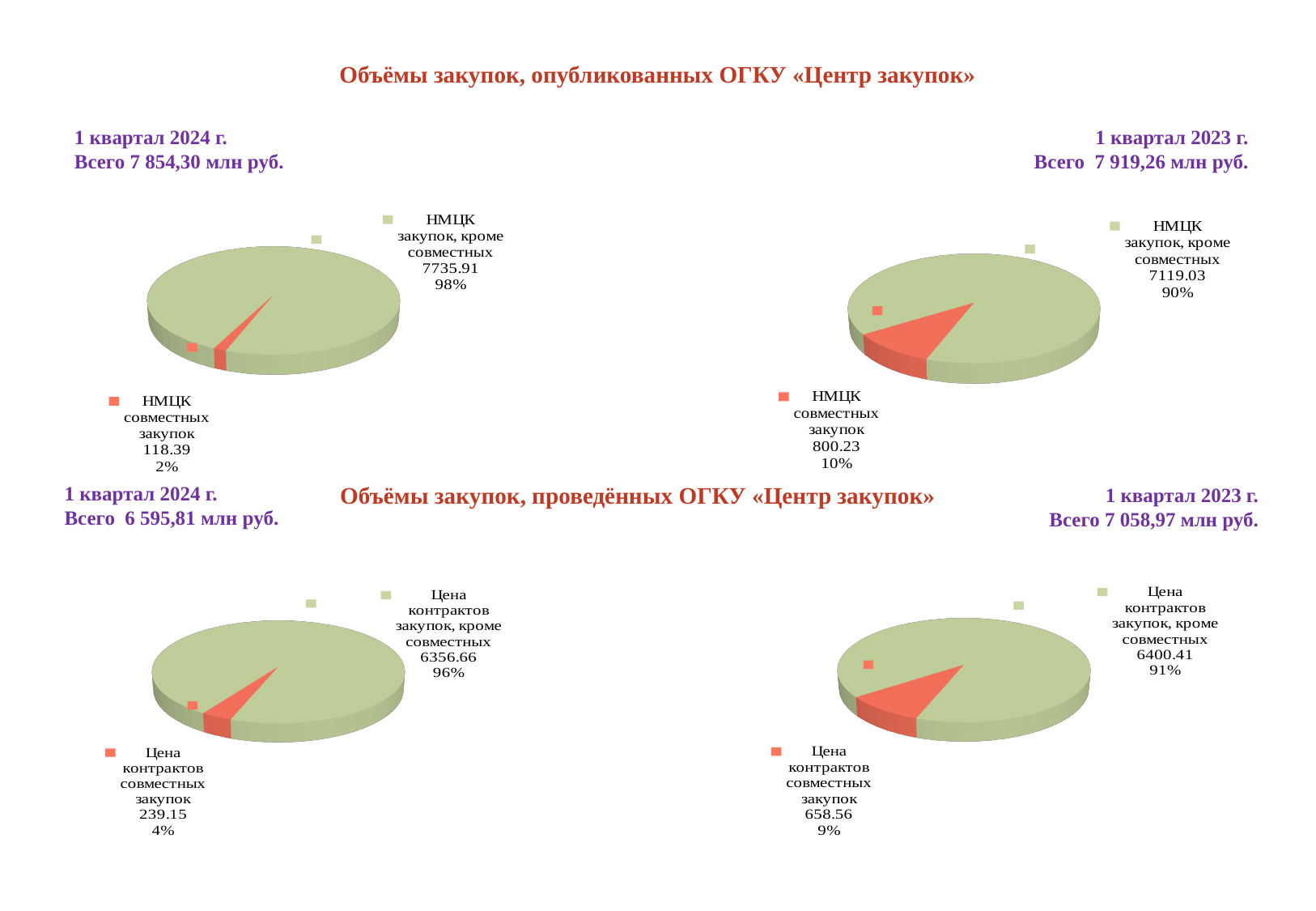
On the bottom-left pie chart (1 квартал 2024 г., conducted purchases), what value is shown for Цена контрактов совместных закупок? 239.15 On the bottom-left pie chart (1 квартал 2024 г., conducted purchases), which slice is the smallest? Цена контрактов совместных закупок On the top-left pie chart (1 квартал 2024 г., published purchases), what value is shown for НМЦК закупок, кроме совместных? 7735.91 On the bottom-right pie chart (1 квартал 2023 г., conducted purchases), what share of the pie is Цена контрактов совместных закупок? 9% On the top-left pie chart (1 квартал 2024 г., published purchases), which slice is the largest? НМЦК закупок, кроме совместных How many slices does the bottom-right pie chart (1 квартал 2023 г., conducted purchases) have? 2 On the top-left pie chart (1 квартал 2024 г., published purchases), what share of the pie is НМЦК совместных закупок? 2% On the bottom-right pie chart (1 квартал 2023 г., conducted purchases), what value is shown for Цена контрактов закупок, кроме совместных? 6400.41 Which is larger: НМЦК совместных закупок on the top-left chart (2024) or on the top-right chart (2023)? Top-right chart (2023) On the top-right pie chart (1 квартал 2023 г., published purchases), what value is shown for НМЦК совместных закупок? 800.23 What type of chart is used for the top-right chart (1 квартал 2023 г., published purchases)? Pie chart On the top-right pie chart (1 квартал 2023 г., published purchases), what share of the pie is НМЦК закупок, кроме совместных? 90%